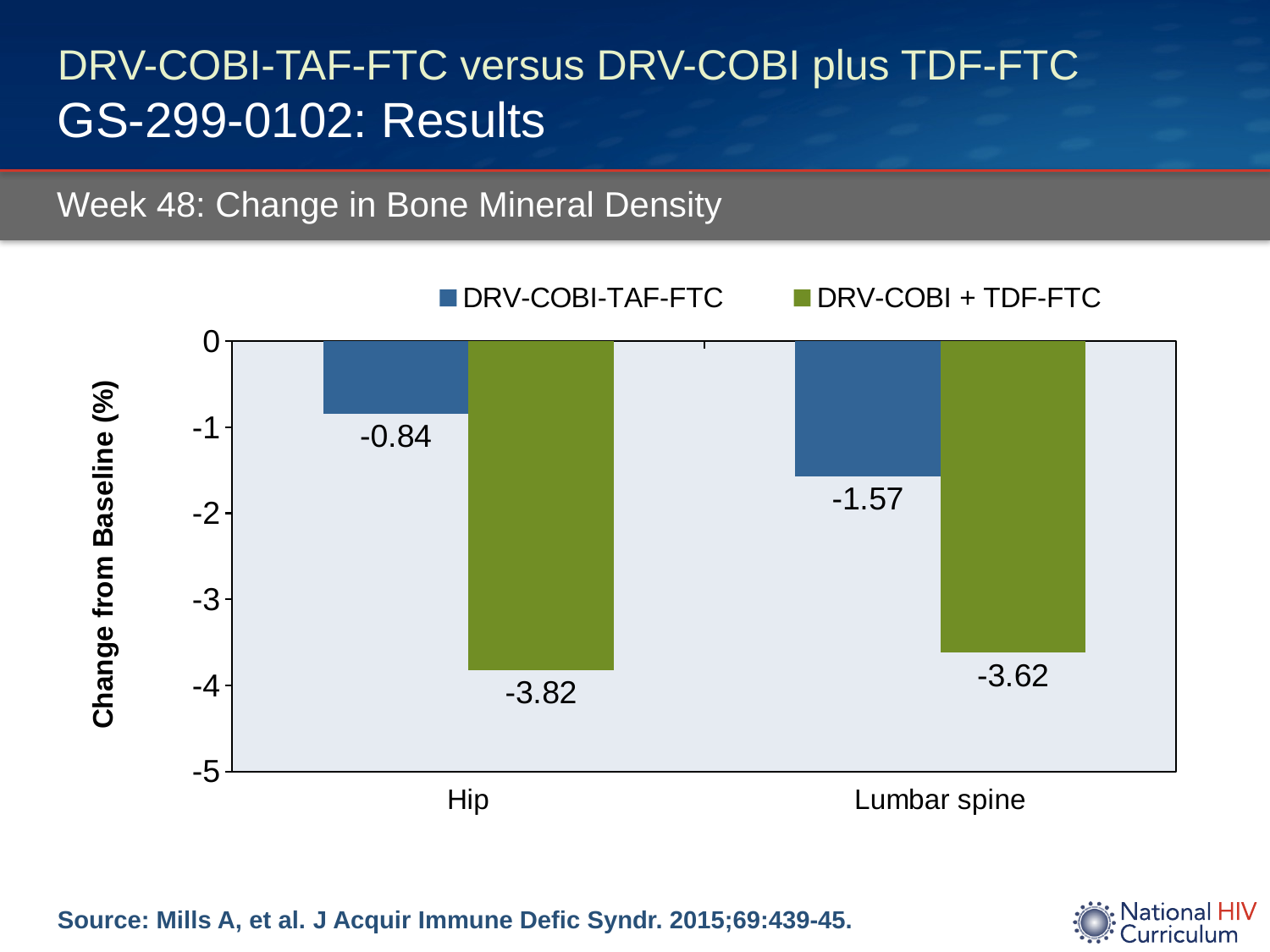
What is the difference between the DRV-COBI + TDF-FTC and DRV-COBI-TAF-FTC values at the Hip? 2.98 How many series does the legend list? 2 What kind of chart is shown on the slide? Bar chart What is the change from baseline for DRV-COBI-TAF-FTC at the Hip? -0.84 Which bar shows the smallest decrease from baseline? DRV-COBI-TAF-FTC at the Hip How many categories are shown on the x axis? 2 What is the change from baseline for DRV-COBI + TDF-FTC at the Hip? -3.82 Which bar shows the largest decrease from baseline? DRV-COBI + TDF-FTC at the Hip What is the change from baseline for DRV-COBI + TDF-FTC at the Lumbar spine? -3.62 What is the change from baseline for DRV-COBI-TAF-FTC at the Lumbar spine? -1.57 Which treatment shows a larger decrease in bone mineral density at the Lumbar spine? DRV-COBI + TDF-FTC What is the difference between the DRV-COBI + TDF-FTC and DRV-COBI-TAF-FTC values at the Lumbar spine? 2.05